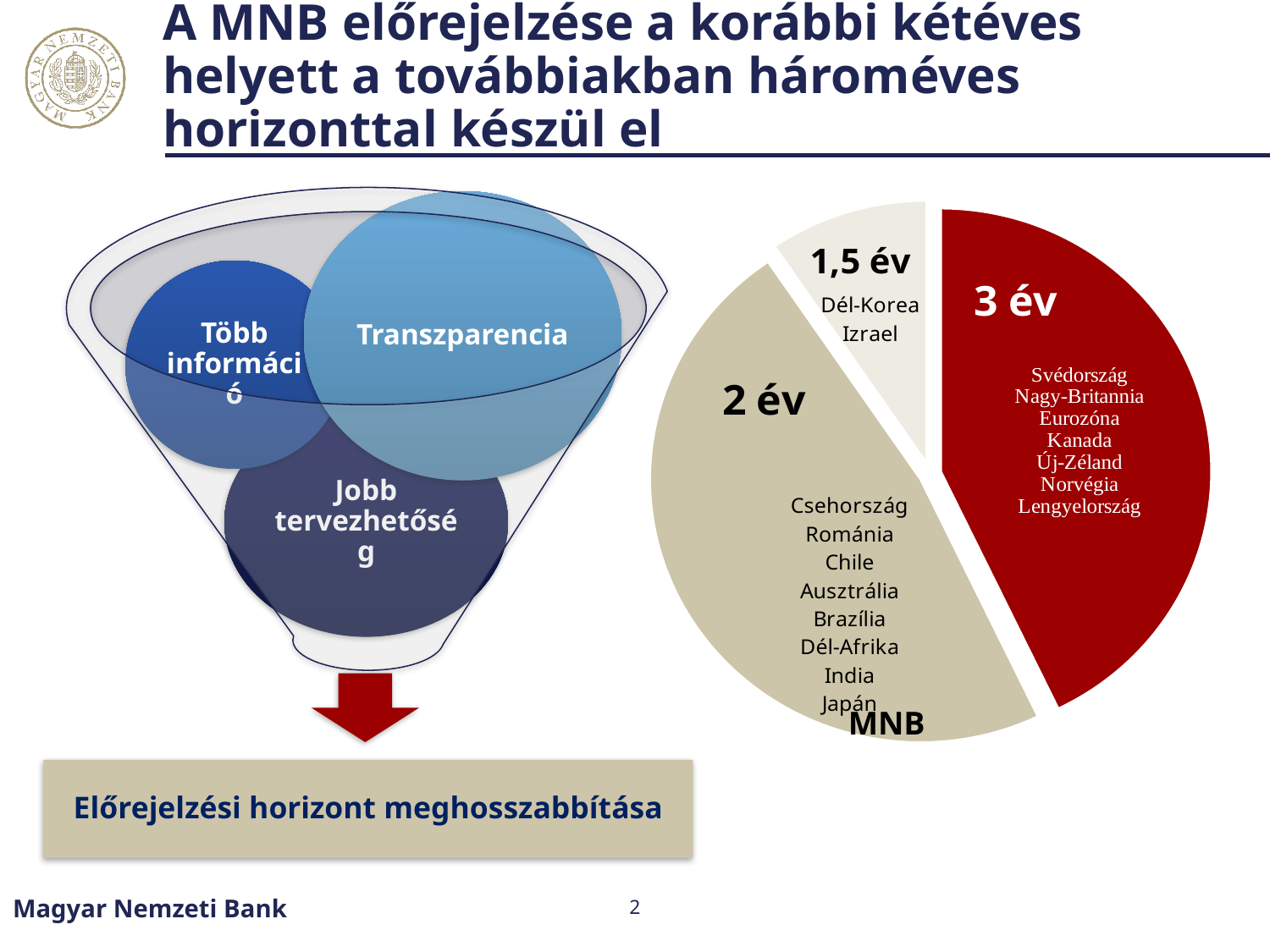
Which slice of the pie chart is the smallest? 1,5 év What colour is the 3 év slice of the pie chart? dark red In which slice of the pie chart does Japán appear? 2 év Which slice of the pie chart is the largest? 2 év Which countries are listed in the 1,5 év slice of the pie chart? Dél-Korea, Izrael How many countries are listed in the 3 év slice of the pie chart? 7 How many slices does the pie chart have? 3 In which slice of the pie chart does Lengyelország appear? 3 év Which slice of the pie chart is labelled MNB? 2 év In the pie chart, which slice is larger: 2 év or 1,5 év? 2 év In the pie chart, which slice is larger: 3 év or 1,5 év? 3 év What kind of chart is shown on the right side of the slide? pie chart